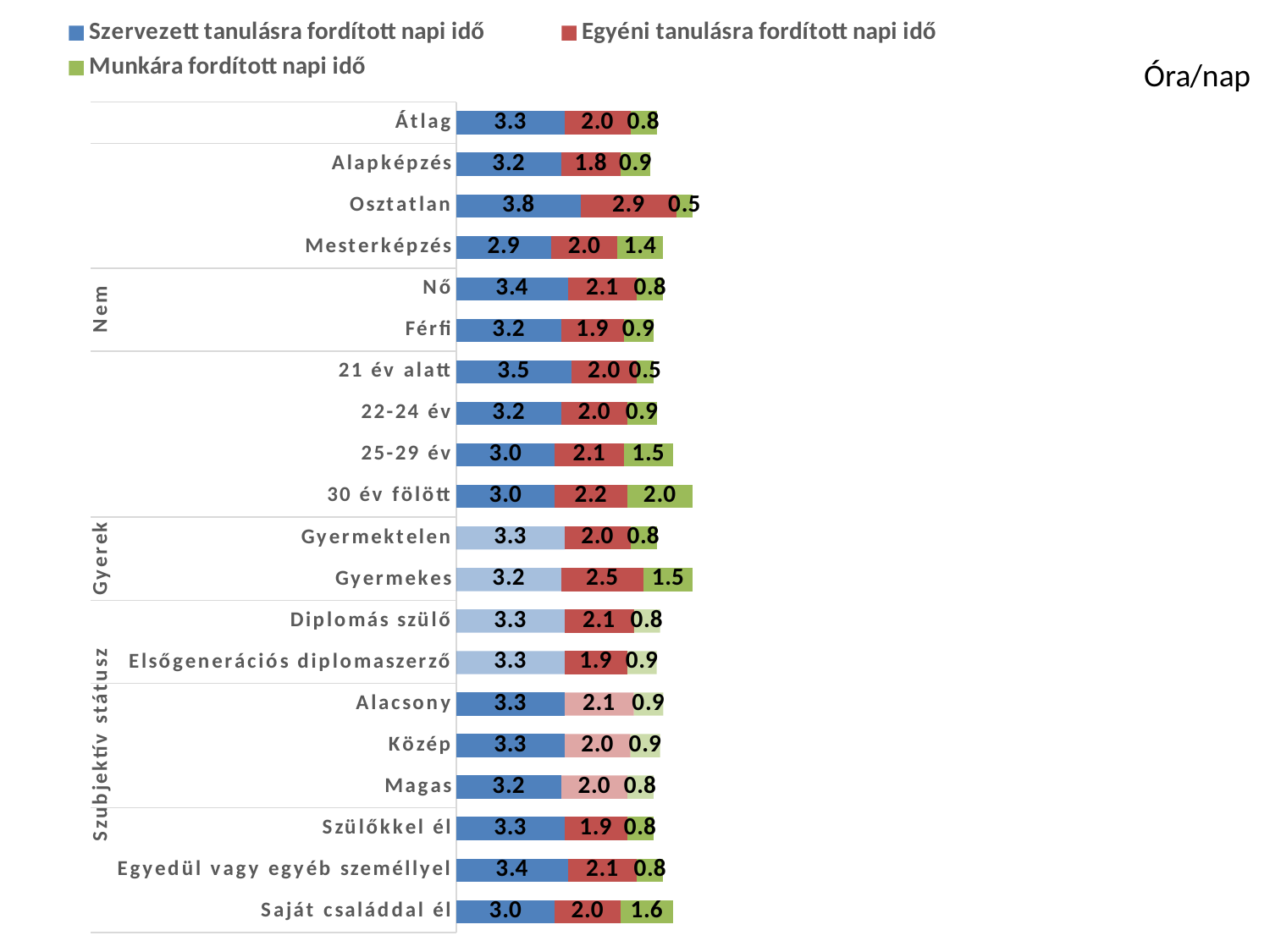
How many series does the legend list? 3 Which category has the highest value for 'Munkára fordított napi idő'? 30 év fölött What is the value of 'Egyéni tanulásra fordított napi idő' for Gyermekes? 2.5 What is the value of 'Munkára fordított napi idő' for 30 év fölött? 2.0 What is the value of 'Szervezett tanulásra fordított napi idő' for Osztatlan? 3.8 What kind of chart is shown on the slide? stacked bar chart What is the total of the stacked bar for Mesterképzés? 6.3 How many categories are plotted on the chart? 20 What unit label is shown at the top right of the chart? Óra/nap What is the difference between the 'Munkára fordított napi idő' values for Saját családdal él and Szülőkkel él? 0.8 Which is larger: the 'Egyéni tanulásra fordított napi idő' value for Osztatlan or for Alapképzés? Osztatlan Which category has the highest value for 'Szervezett tanulásra fordított napi idő'? Osztatlan